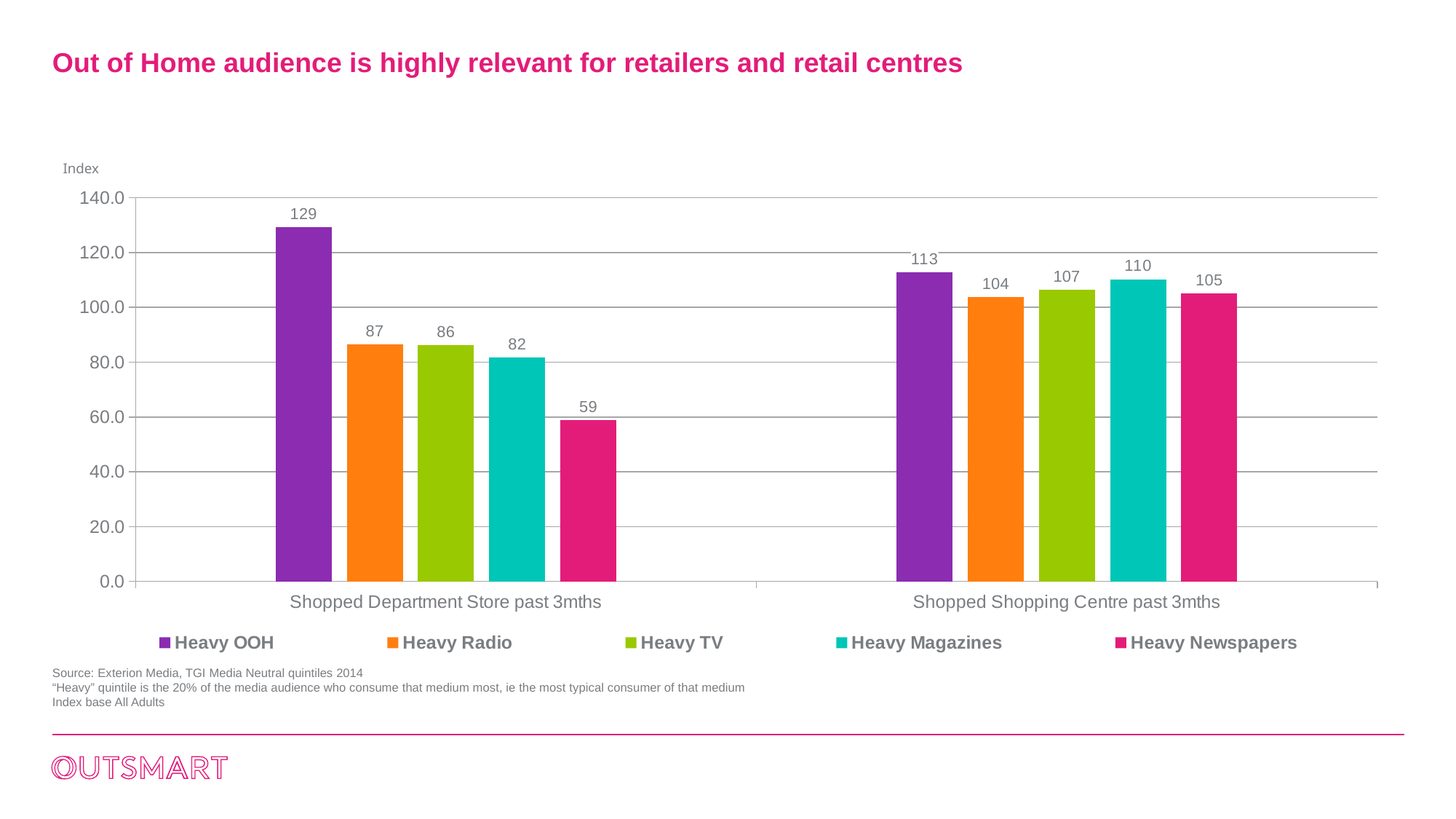
Which series has the highest index value in the Shopped Shopping Centre past 3mths category? Heavy OOH How many series does the legend list? 5 Which is larger: the Heavy Radio index for Shopped Department Store past 3mths or for Shopped Shopping Centre past 3mths? Shopped Shopping Centre past 3mths What is the difference between the Heavy OOH and Heavy Newspapers index values in the Shopped Department Store past 3mths category? 70 Which series has the lowest index value in the Shopped Department Store past 3mths category? Heavy Newspapers What is the index value for Heavy Magazines in the Shopped Department Store past 3mths category? 82 What is the index value for Heavy Newspapers in the Shopped Shopping Centre past 3mths category? 105 What is the difference between the Heavy OOH index values for Shopped Department Store past 3mths and Shopped Shopping Centre past 3mths? 16 What kind of chart is shown on the slide? Bar chart What is the index value for Heavy OOH in the Shopped Department Store past 3mths category? 129 How many categories are shown on the x axis? 2 Is the Heavy TV index value for Shopped Shopping Centre past 3mths greater or less than 100? greater